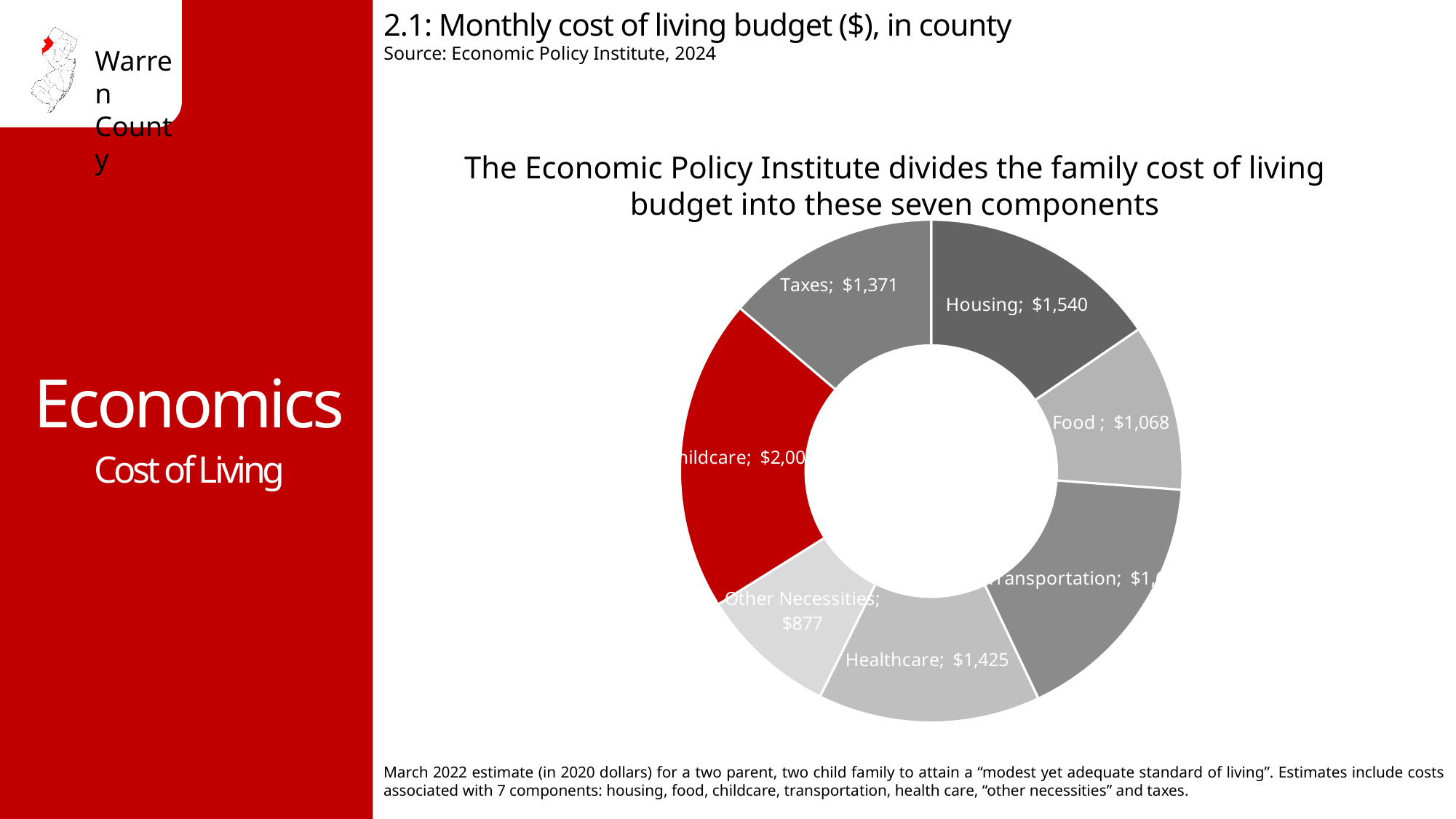
What kind of chart is shown on the slide? Pie (donut) chart How many components are shown in the chart? 7 What is the monthly cost for Healthcare shown on the chart? $1,425 What is the monthly cost for Housing shown on the chart? $1,540 Which component has the smallest slice of the chart? Other Necessities Which is larger, the Housing value or the Healthcare value? Housing Which component has the largest slice of the chart? Childcare What is the monthly cost for Other Necessities shown on the chart? $877 What is the monthly cost for Taxes shown on the chart? $1,371 What is the monthly cost for Food shown on the chart? $1,068 What is the difference between the Housing and Taxes values? $169 What is the difference between the Healthcare and Food values? $357